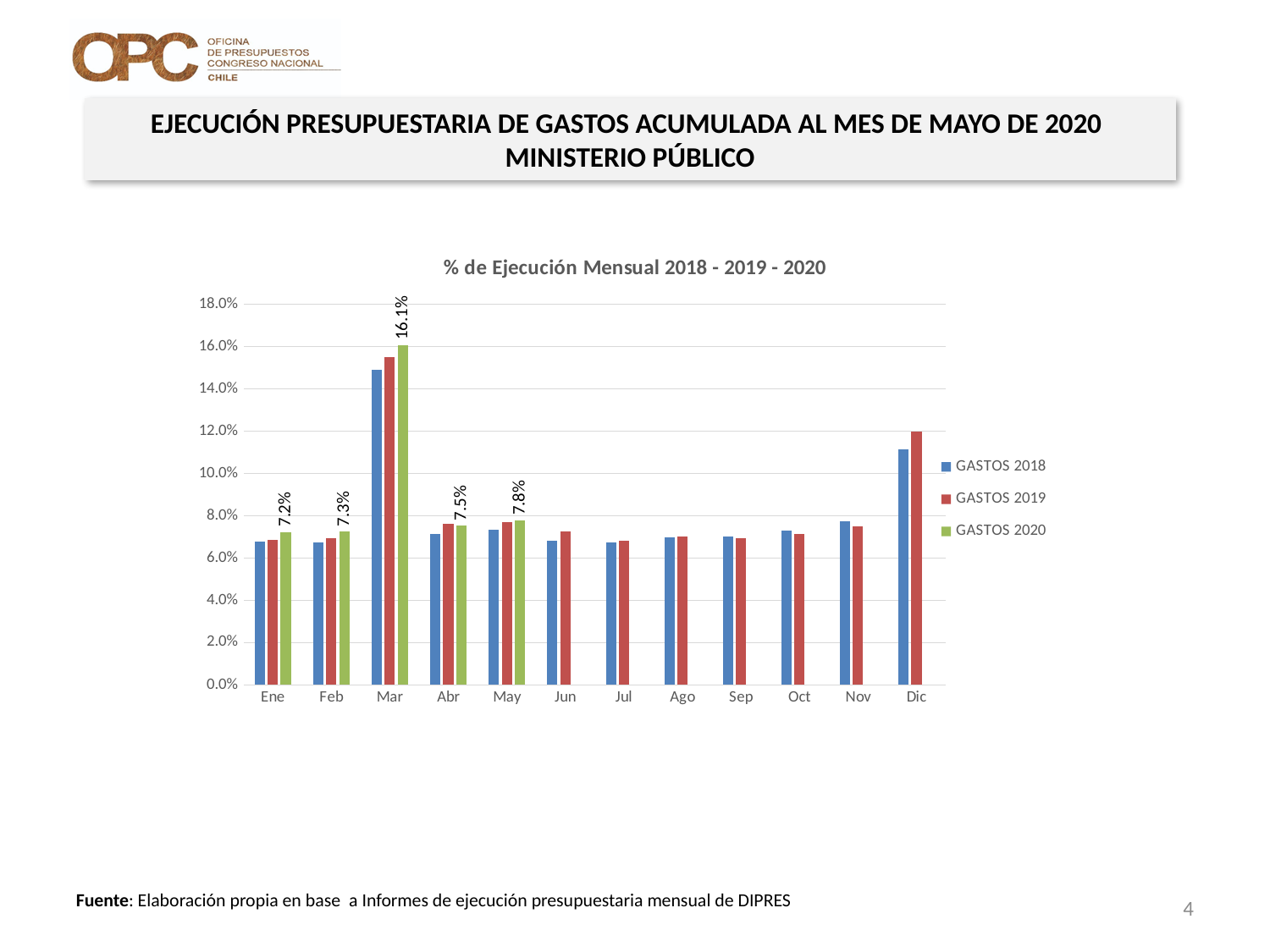
What is the value for GASTOS 2020 in Mar? 16.1% What is the value for GASTOS 2020 in Ene? 7.2% What is the value for GASTOS 2020 in May? 7.8% Is the value for GASTOS 2019 in Dic greater or less than 10.0%? greater Which is larger for GASTOS 2020: the value for May or the value for Ene? May What is the value for GASTOS 2020 in Abr? 7.5% How many months are shown on the x axis? 12 What kind of chart is shown on the slide? Bar chart Which month has the lowest value for GASTOS 2020? Ene What is the difference between the GASTOS 2020 values for Mar and Feb? 8.8% How many series does the legend list? 3 Which month has the highest value for GASTOS 2020? Mar